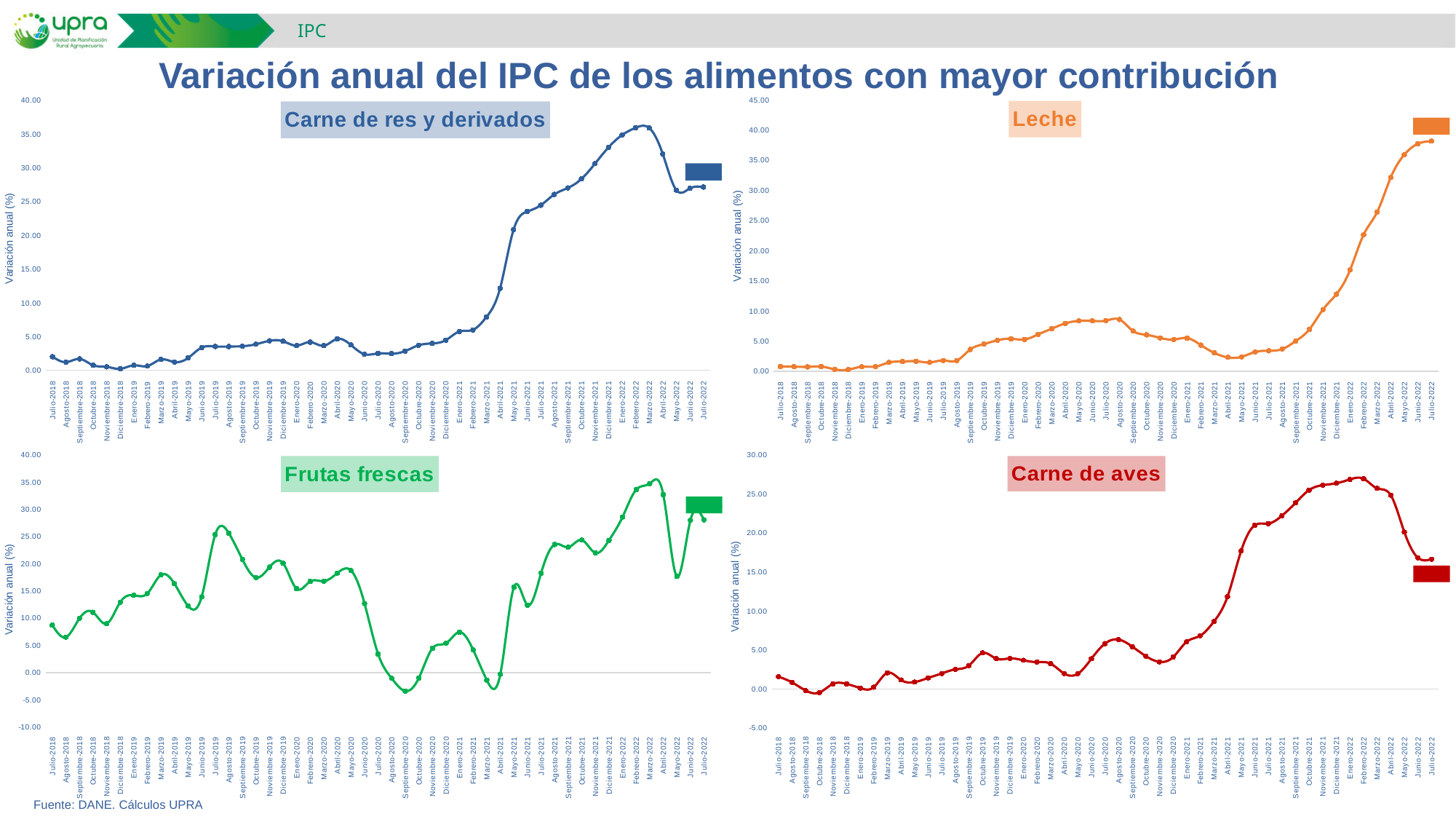
In the 'Carne de aves' chart, is the value for Julio-2022 greater or less than 15.00? greater What is the main title of the slide? Variación anual del IPC de los alimentos con mayor contribución How many charts are shown on the slide? 4 In the 'Leche' chart, is the value for Julio-2022 greater or less than 35.00? greater In the 'Frutas frescas' chart, is the value for Marzo-2022 greater or less than 30.00? greater In the 'Leche' chart, which month has the highest value? Julio-2022 For Julio-2022, which is larger: the value in the 'Leche' chart or the value in the 'Carne de aves' chart? Leche In the 'Leche' chart, do values overall rise or fall from Julio-2018 to Julio-2022? rise What kind of chart is the 'Leche' chart? line chart